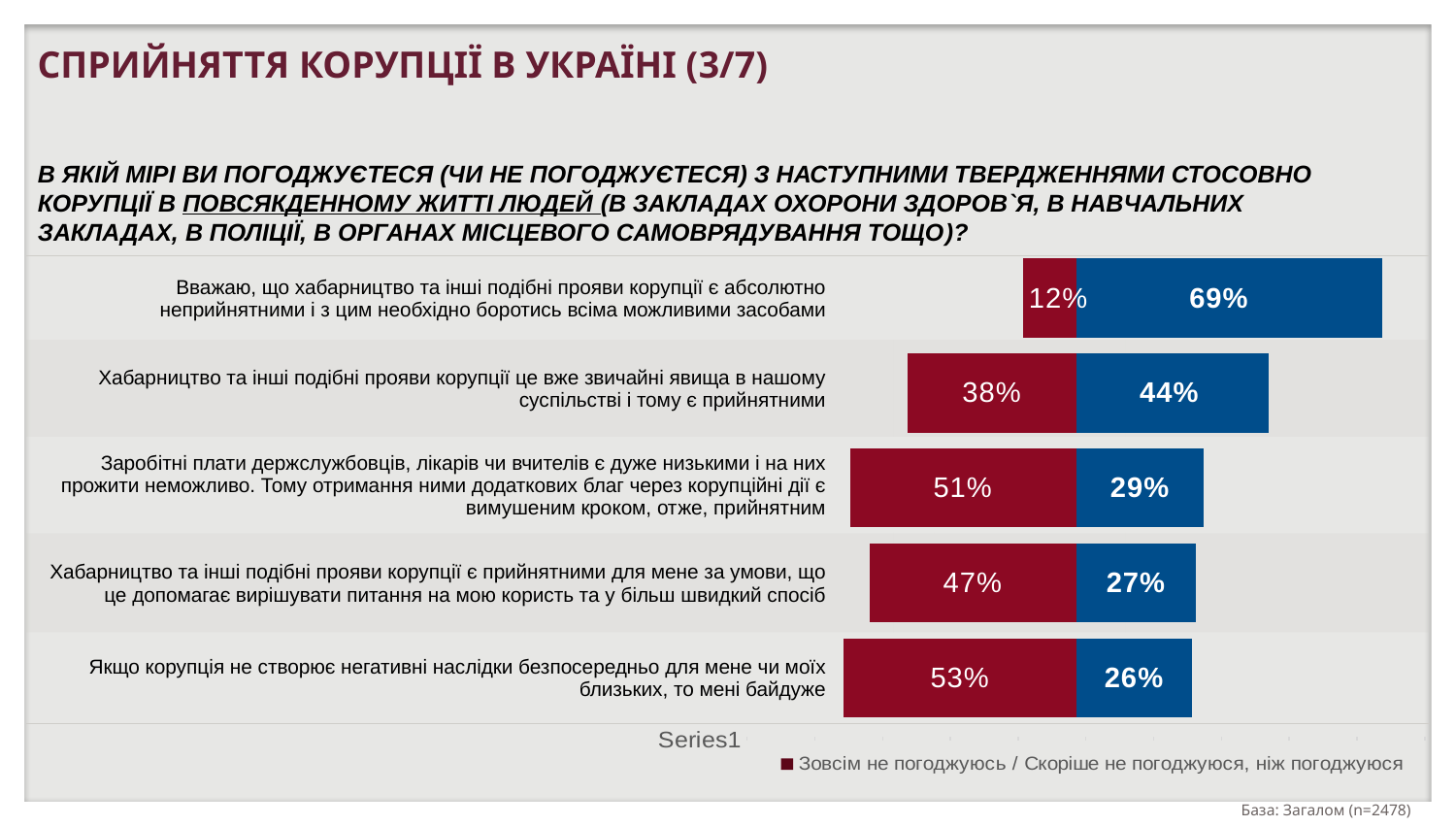
What is the base (sample size) stated on the slide? n=2478 What is the red (disagree) value for the statement that bribery is already a common phenomenon in our society and therefore acceptable? 38% How many statements (categories) are shown in the chart? 5 Which statement has the highest blue (agree) value? Вважаю, що хабарництво та інші подібні прояви корупції є абсолютно неприйнятними і з цим необхідно боротись всіма можливими засобами What type of chart is shown on the slide? bar chart What is the red (disagree) value for the statement that bribery is absolutely unacceptable and must be fought by all means? 12% What is the red (disagree) value for the statement 'If corruption does not create negative consequences directly for me or my relatives, I don't care'? 53% Which statement has the lowest red (disagree) value? Вважаю, що хабарництво та інші подібні прояви корупції є абсолютно неприйнятними і з цим необхідно боротись всіма можливими засобами What is the difference between the red and blue values for the statement that bribery is acceptable if it helps resolve issues in my favour faster? 20% What is the blue (agree) value for the statement that bribery is absolutely unacceptable and must be fought by all means? 69% For the statement that bribery is already a common phenomenon and therefore acceptable, which is larger: the red (disagree) value or the blue (agree) value? blue (44%) What is the blue (agree) value for the statement that salaries of civil servants, doctors and teachers are very low, so obtaining extra benefits through corruption is acceptable? 29%